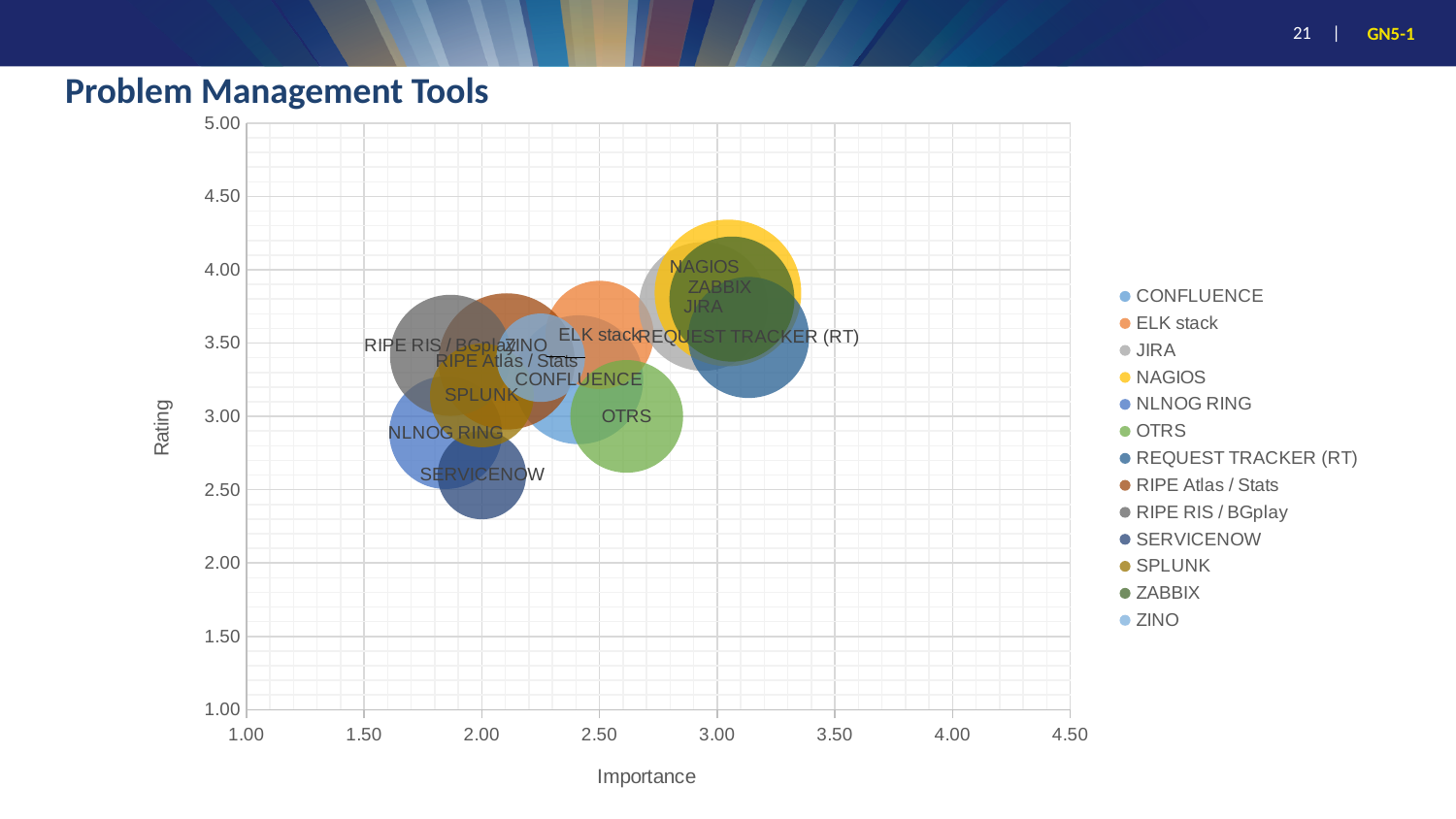
What kind of chart is shown on the slide? bubble chart Which has the higher rating, NAGIOS or SERVICENOW? NAGIOS Which tool has the highest rating? NAGIOS Is the importance for NAGIOS greater or less than 2.50? greater How many series does the legend list? 13 What is the label of the vertical axis? Rating Which tool has the lowest rating? SERVICENOW Is the rating for SERVICENOW greater or less than 3.00? less Is the rating for ZABBIX greater or less than 3.00? greater How many tools are plotted as bubbles on the chart? 13 What is the title of the chart? Problem Management Tools